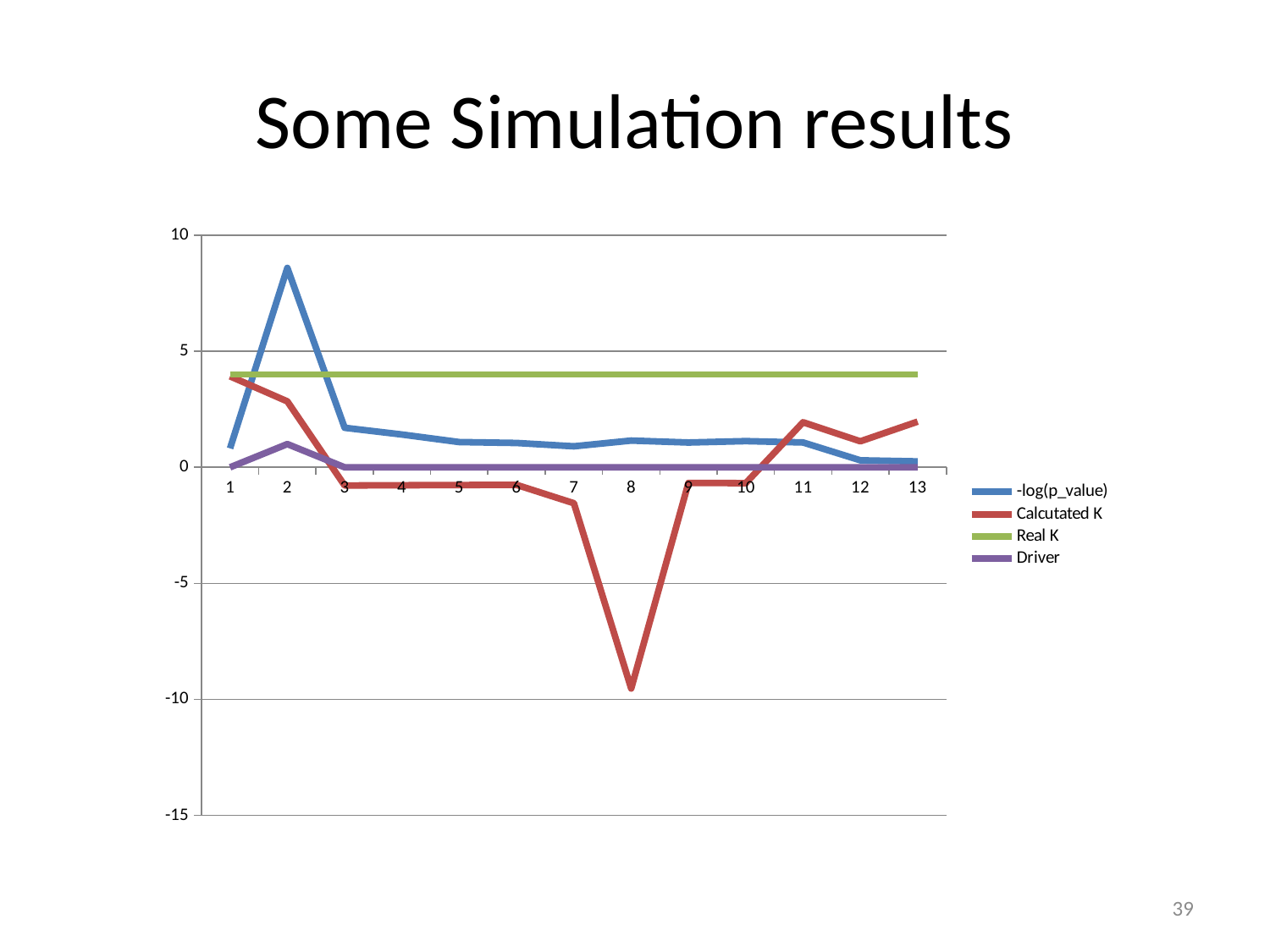
How many series does the legend list? 4 Is the value of Calcutated K at x = 8 greater or less than -5? less At which x value does the Calcutated K series reach its lowest point? 8 Is the value of Real K at x = 6 greater or less than 5? less What kind of chart is shown on the slide? line chart At x = 8, which is larger: Real K or Calcutated K? Real K At x = 2, which is larger: -log(p_value) or Calcutated K? -log(p_value) What is the value of the Driver series at x = 5? 0 What is the title of the slide containing the chart? Some Simulation results How many points are plotted along the x axis? 13 At which x value does the -log(p_value) series reach its highest point? 2 Is the value of -log(p_value) at x = 2 greater or less than 5? greater